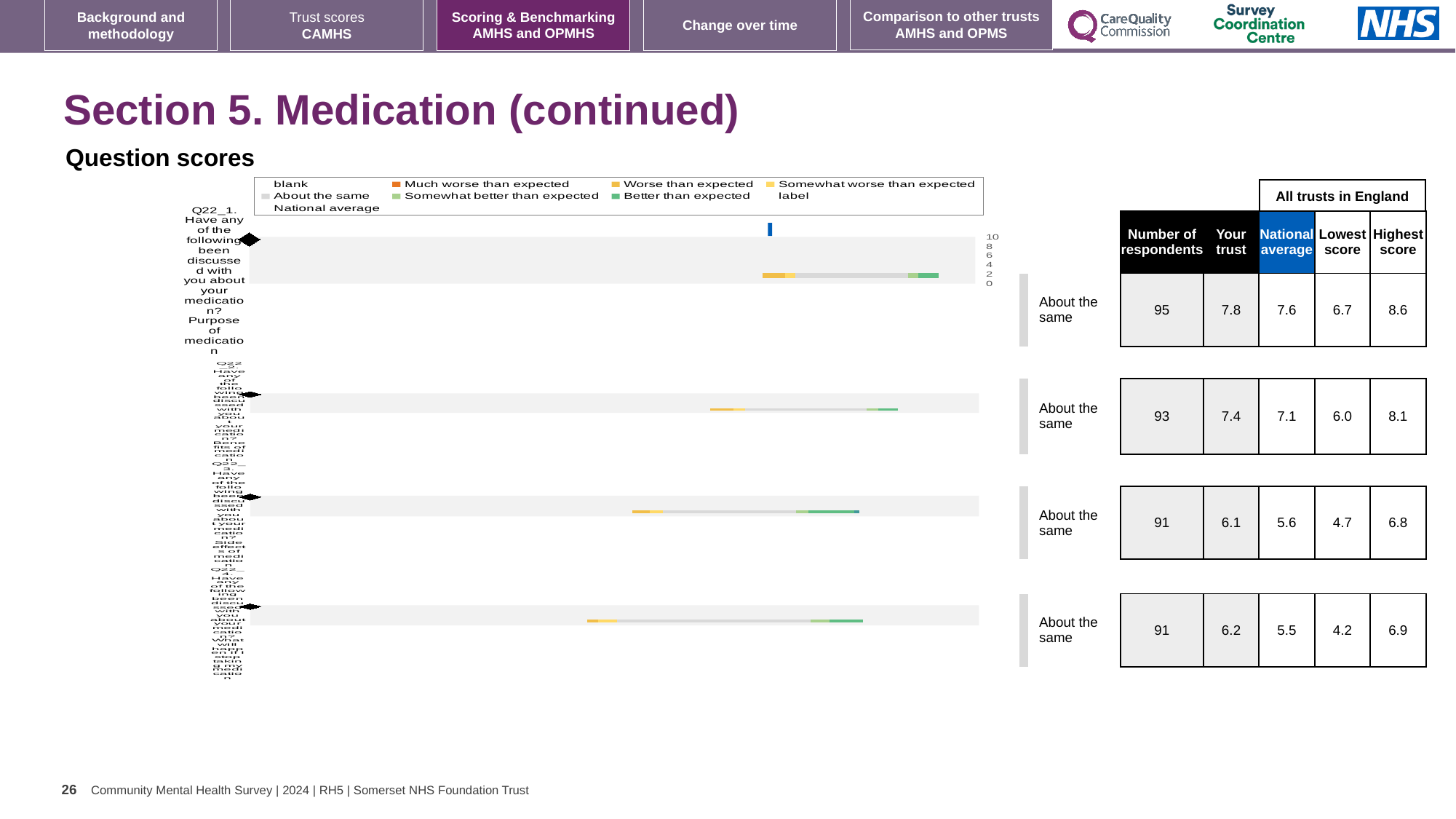
What is the maximum value shown on the chart's score axis? 10 What kind of chart is shown under 'Question scores'? bar chart In the table beside the chart, what is the lowest 'Lowest score' value across the four rows? 4.2 In the table beside the chart, is 'Your trust' or the national average larger in the fourth row? Your trust In the table beside the chart, how many respondents are listed in the first row? 95 In the table beside the chart, what is the difference between 'Your trust' and the national average in the third row? 0.5 Which legend entry is shown in dark green? Better than expected In the table beside the chart, what is the national average in the first row? 7.6 How many question bars are plotted in the chart? 4 In the table beside the chart, which row has the highest 'Your trust' score? the first row (7.8) In the table beside the chart, what is the 'Your trust' score in the first row (Q22_1, purpose of medication)? 7.8 What benchmark category is shown next to each of the four bars? About the same